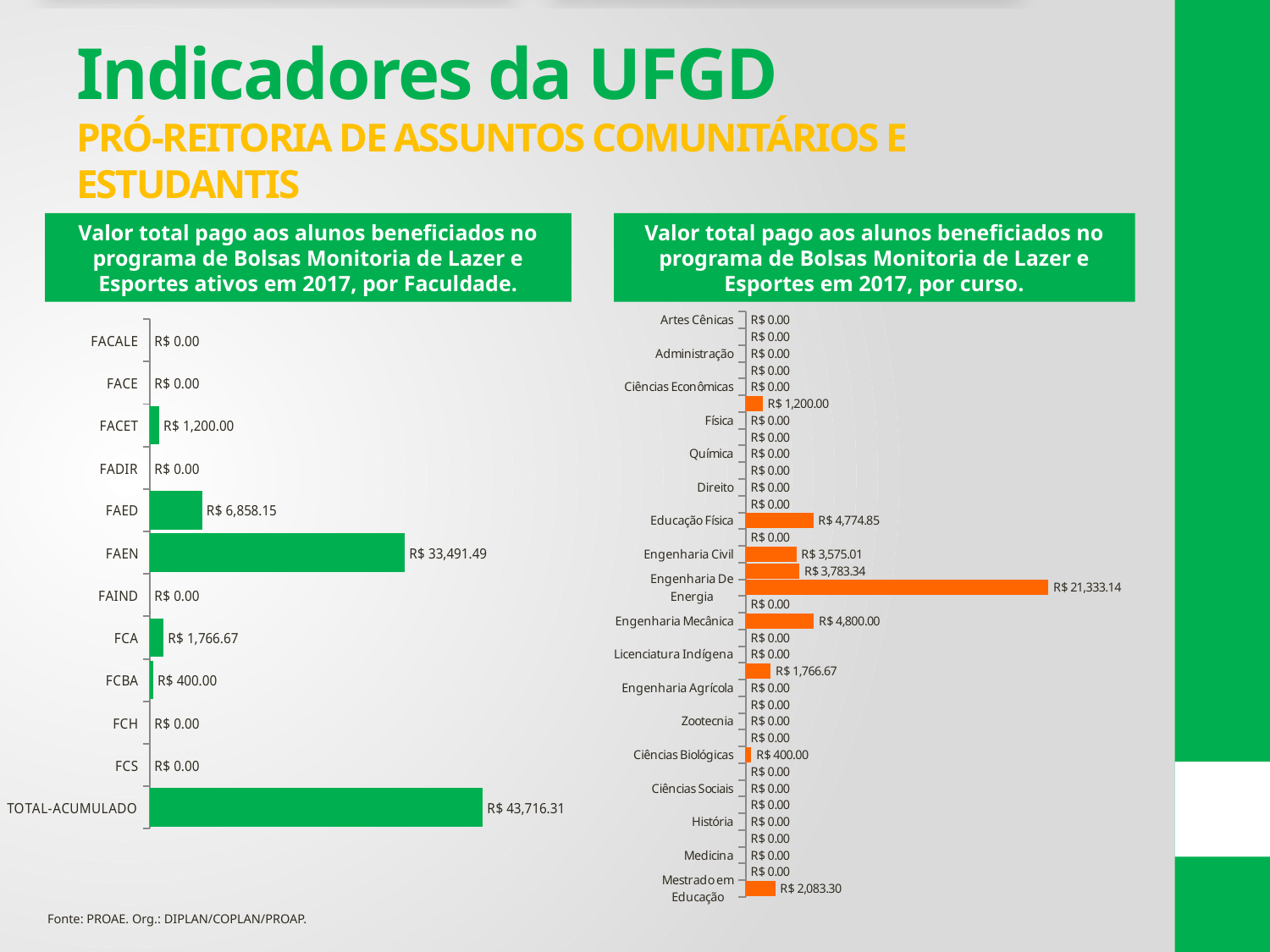
What type of chart is the left chart (by Faculdade)? Bar chart In the left chart (by Faculdade), what is the value for TOTAL-ACUMULADO? R$ 43,716.31 In the left chart (by Faculdade), which is larger, the value for FCA or the value for FACET? FCA In the left chart (by Faculdade), which faculdade (excluding TOTAL-ACUMULADO) has the highest value? FAEN In the right chart (by curso), what is the value for Mestrado em Educação? R$ 2,083.30 In the left chart (by Faculdade), what is the value for FAED? R$ 6,858.15 In the right chart (by curso), what is the value for Educação Física? R$ 4,774.85 In the left chart (by Faculdade), how many categories are shown on the axis? 12 In the left chart (by Faculdade), what is the difference between the values for FAEN and FAED? R$ 26,633.34 In the right chart (by curso), what is the value for Engenharia Mecânica? R$ 4,800.00 In the left chart (by Faculdade), what is the value for FAEN? R$ 33,491.49 What colour are the bars in the right chart (by curso)? Orange